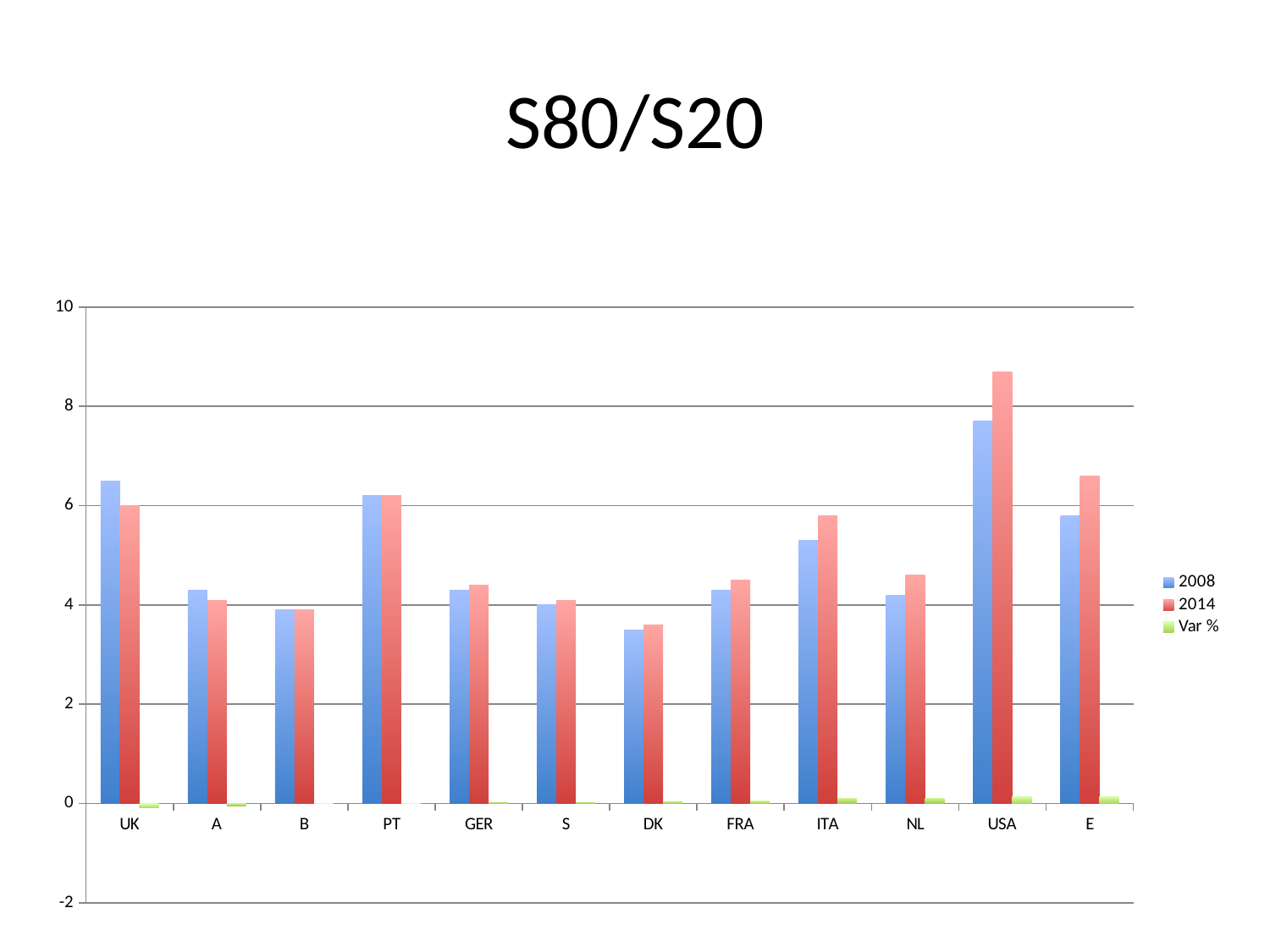
What is the title of the chart? S80/S20 How many countries are shown on the x axis? 12 Is the 2008 value for DK greater or less than 4? less For UK, which is larger: the 2008 value or the 2014 value? 2008 For USA, which is larger: the 2008 value or the 2014 value? 2014 Is the 2014 value for USA greater or less than 8? greater How many series does the legend list? 3 Which country has the highest 2014 value? USA Which country has the lowest 2008 value? DK What kind of chart is shown on the slide? bar chart Is the 2014 value for ITA greater or less than 6? less